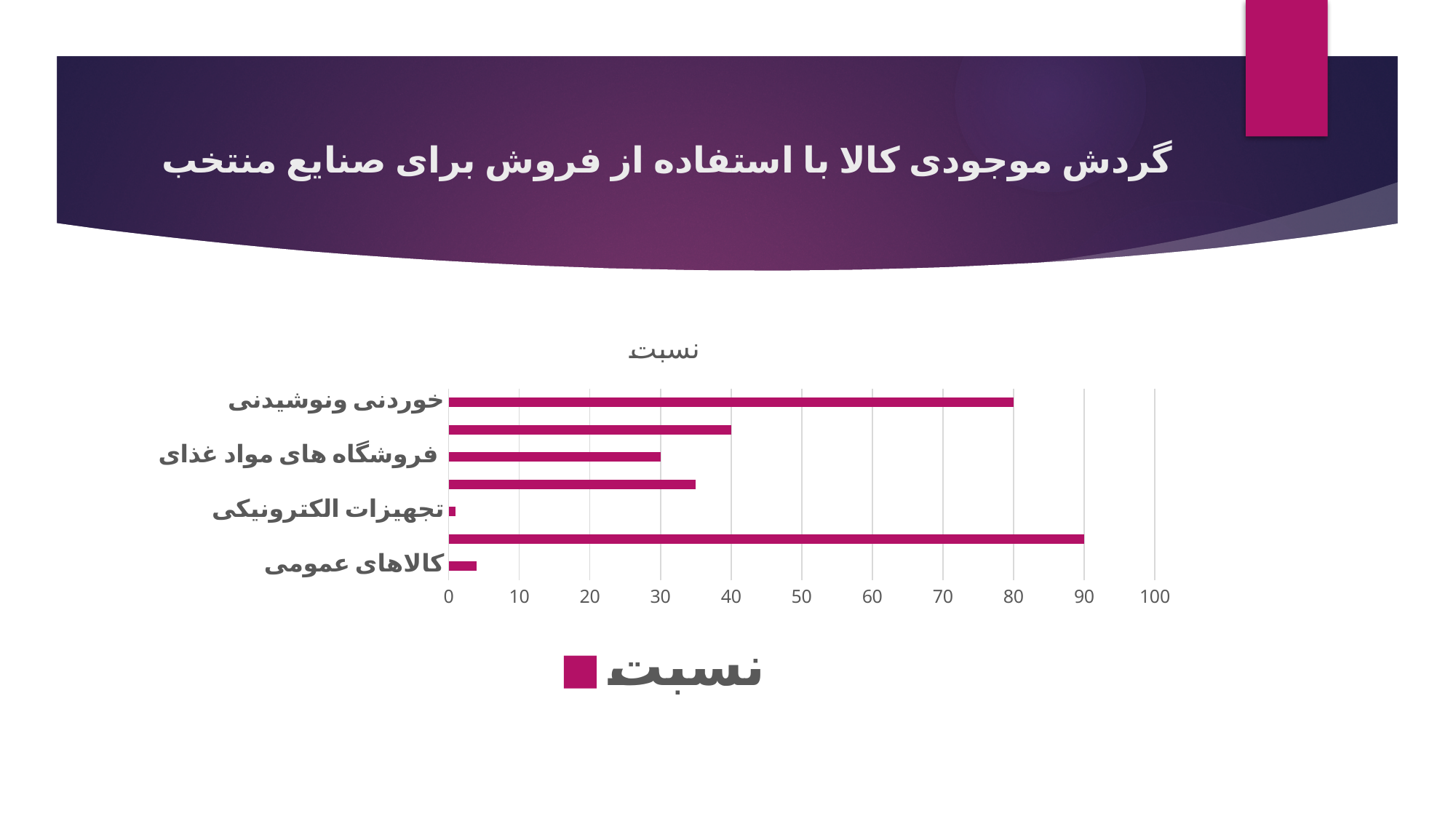
What is the difference between the values for خوردنی ونوشیدنی and فروشگاه های مواد غذای? 50 What is the legend entry of the chart? نسبت Which is larger, the value for خوردنی ونوشیدنی or the value for فروشگاه های مواد غذای? خوردنی ونوشیدنی What is the value for خوردنی ونوشیدنی? 80 What is the title of the chart? نسبت What is the value for فروشگاه های مواد غذای? 30 How many bars are plotted in the chart? 7 Is the value for خوردنی ونوشیدنی greater or less than 50? greater How many series does the legend list? 1 What kind of chart is shown on the slide? bar chart Is the value for کالاهای عمومی greater or less than 10? less Is the value for تجهیزات الکترونیکی greater or less than 10? less